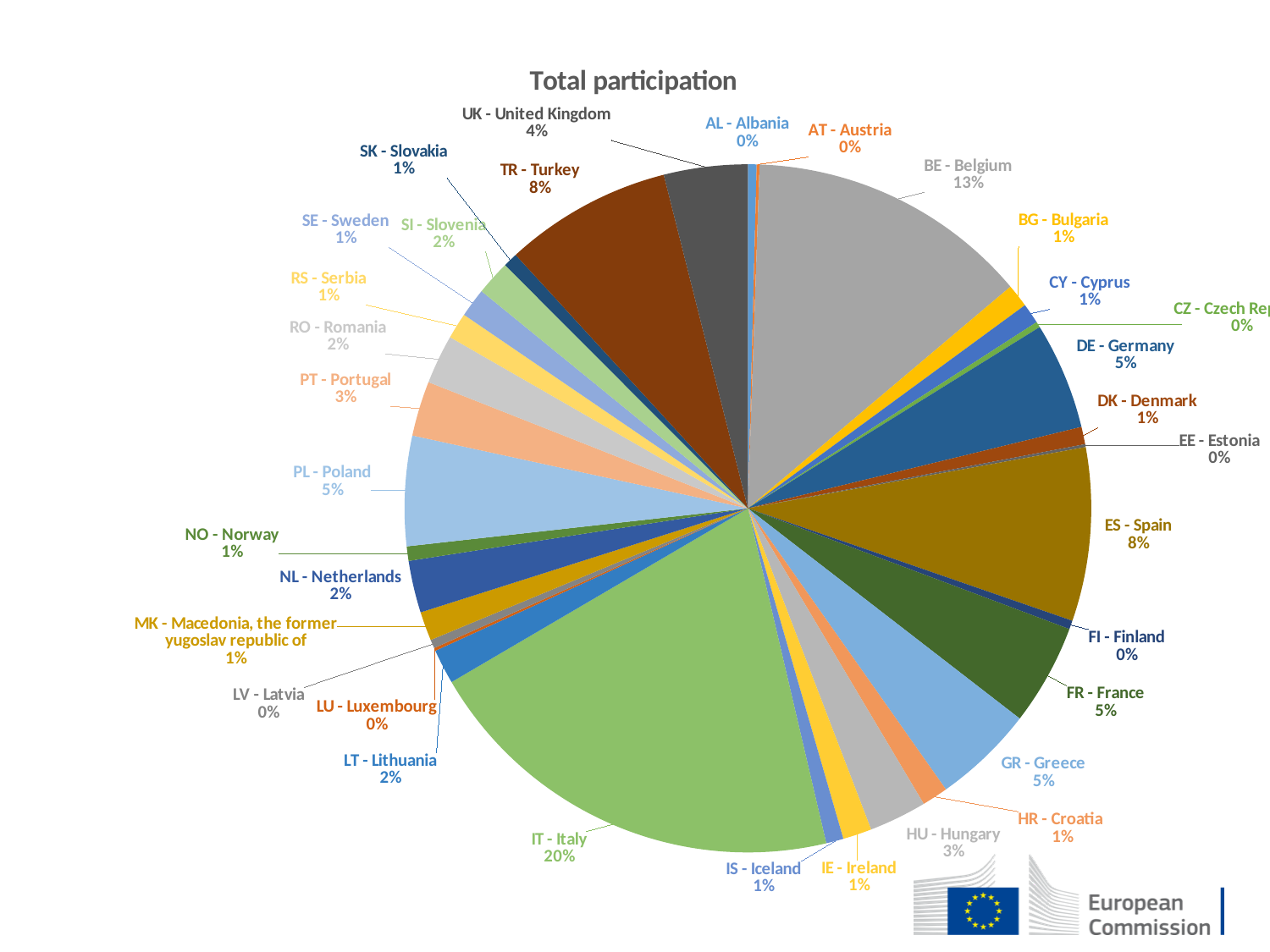
Which has the larger share, DE - Germany or HU - Hungary? DE - Germany What is the title of the chart? Total participation What percentage is shown for PT - Portugal? 3% What kind of chart is shown on the slide? pie chart What share of total participation does BE - Belgium have? 13% How many countries are labelled in the pie chart? 33 What percentage is shown for TR - Turkey? 8% What percentage is shown for UK - United Kingdom? 4% Which country has the largest share of total participation? IT - Italy What share of total participation does IT - Italy have? 20% By how many percentage points does IT - Italy's share exceed BE - Belgium's share? 7 percentage points What percentage is shown for ES - Spain? 8%